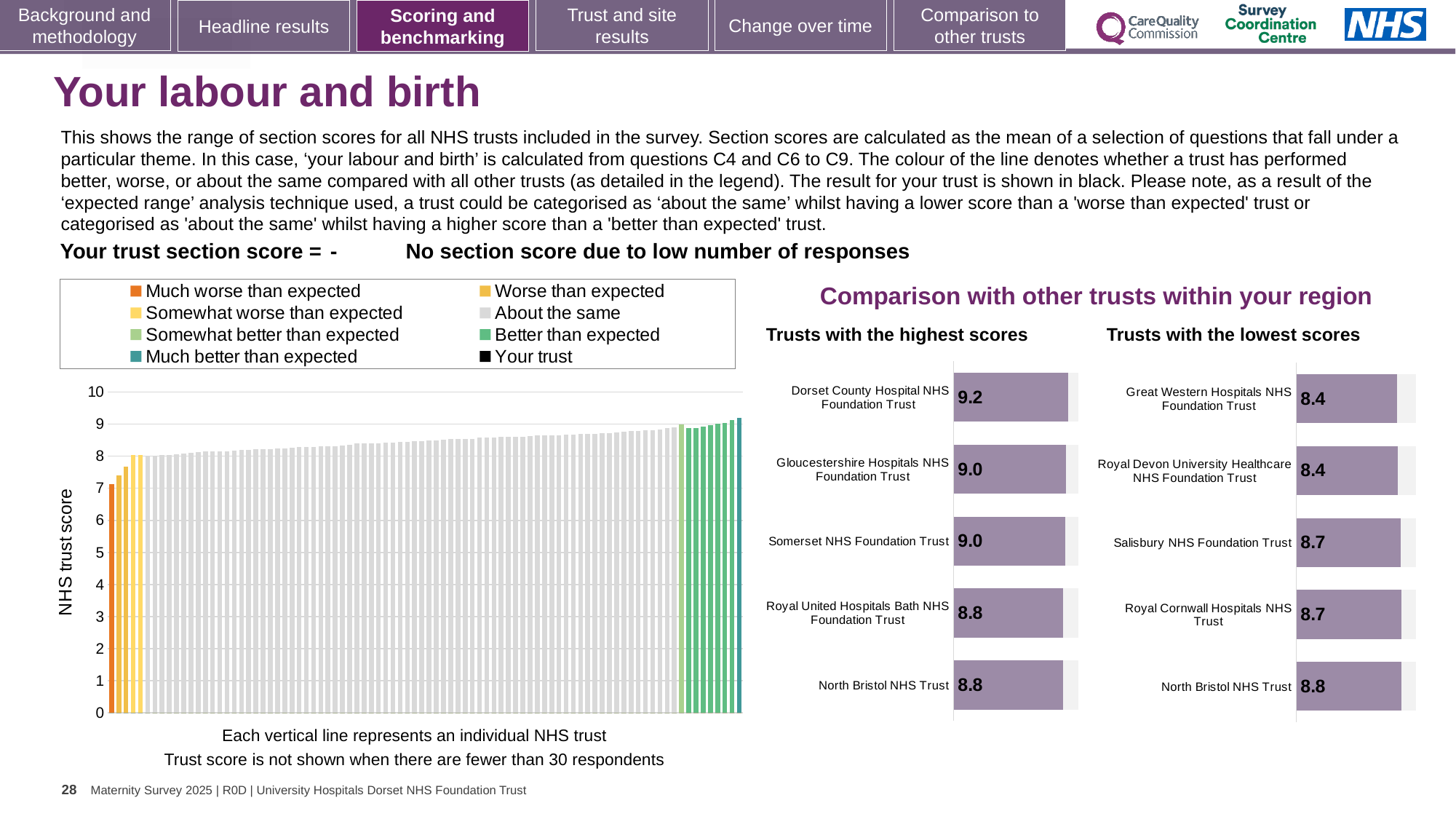
In the 'Trusts with the highest scores' chart, what is the difference between the scores of Dorset County Hospital NHS Foundation Trust and North Bristol NHS Trust? 0.4 How many entries does the legend above the large chart on the left list? 8 In the large chart on the left, do the NHS trust scores rise or fall from left to right? Rise What kind of chart is the large chart on the left showing NHS trust scores? Bar chart In the 'Trusts with the highest scores' chart, which trust has the highest score? Dorset County Hospital NHS Foundation Trust In the 'Trusts with the highest scores' chart, how many trusts are listed? 5 In the 'Trusts with the lowest scores' chart, what is the score for Great Western Hospitals NHS Foundation Trust? 8.4 In the 'Trusts with the lowest scores' chart, which is larger: the score for Royal Cornwall Hospitals NHS Trust or the score for Royal Devon University Healthcare NHS Foundation Trust? Royal Cornwall Hospitals NHS Trust In the 'Trusts with the highest scores' chart, what is the score for Dorset County Hospital NHS Foundation Trust? 9.2 In the 'Trusts with the lowest scores' chart, which trust has the highest score shown? North Bristol NHS Trust In the 'Trusts with the lowest scores' chart, what is the score for Salisbury NHS Foundation Trust? 8.7 In the 'Trusts with the lowest scores' chart, what is the difference between the scores of North Bristol NHS Trust and Great Western Hospitals NHS Foundation Trust? 0.4